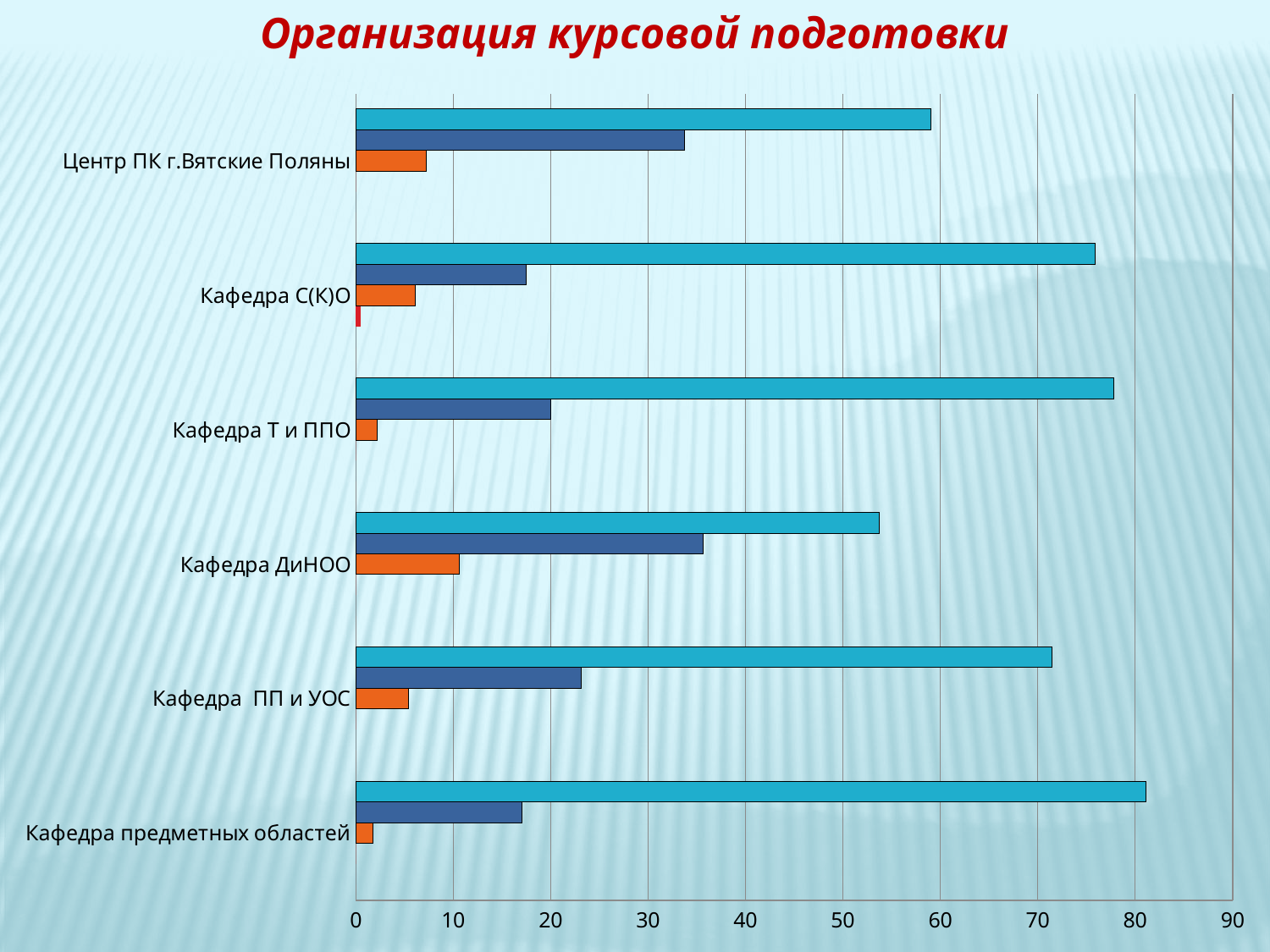
What kind of chart is shown on the slide? bar chart Is the light blue bar for Центр ПК г.Вятские Поляны greater or less than 50? greater What is the title of the slide? Организация курсовой подготовки Which category has the longest orange bar? Кафедра ДиНОО How many categories are shown on the vertical axis of the chart? 6 Which has the longer light blue bar: Кафедра С(К)О or Кафедра ДиНОО? Кафедра С(К)О Is the light blue bar for Кафедра предметных областей greater or less than 70? greater Is the orange bar for Кафедра ДиНОО greater or less than 20? less Which has the longer dark blue bar: Центр ПК г.Вятские Поляны or Кафедра ПП и УОС? Центр ПК г.Вятские Поляны Which category has the longest light blue bar? Кафедра предметных областей Which category has the shortest light blue bar? Кафедра ДиНОО